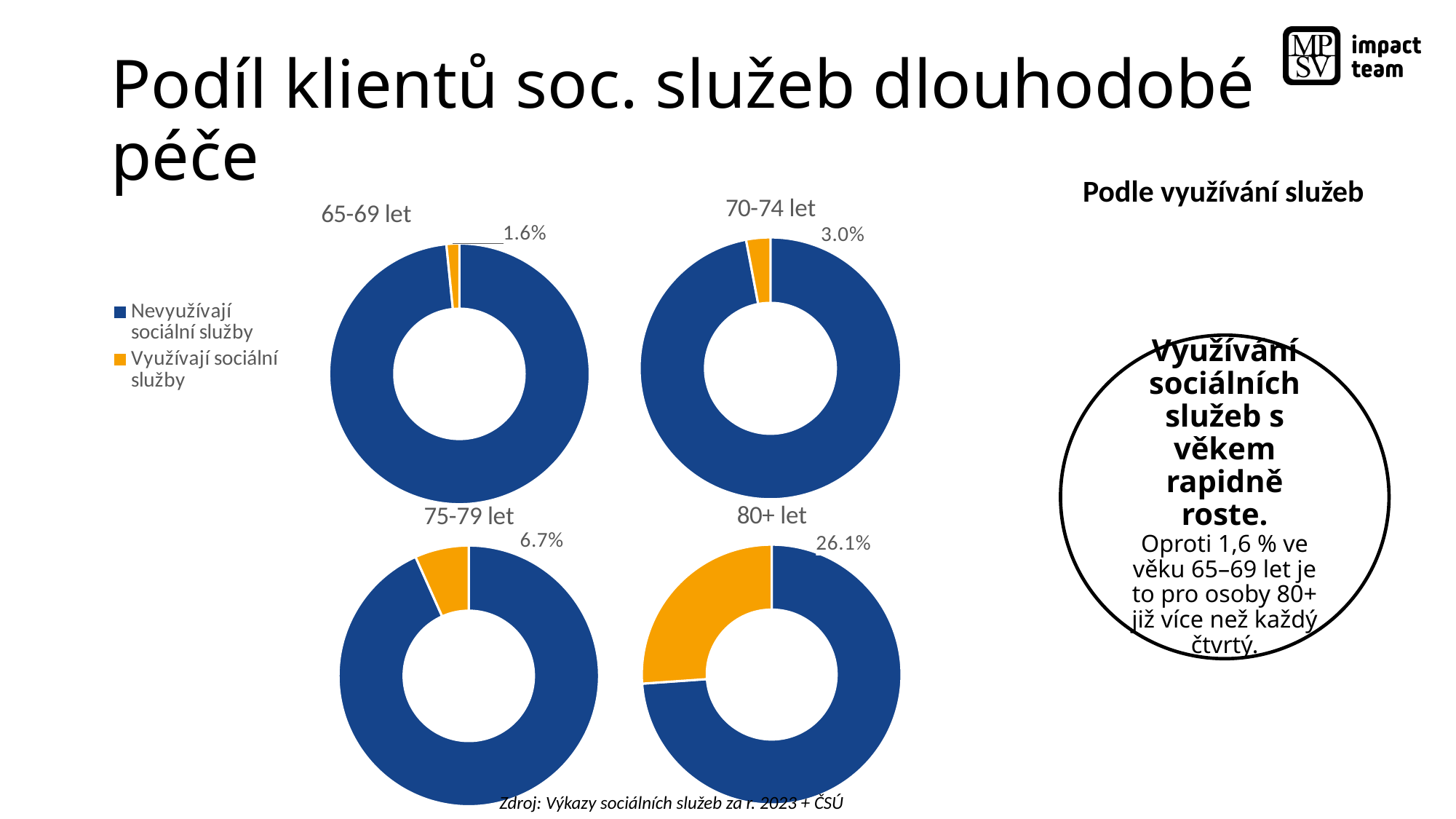
How many series does the legend list for the charts? 2 Across the four donut charts, which age group has the highest labelled share of 'Využívají sociální služby'? 80+ let How many donut charts are shown on the slide? 4 In the '80+ let' chart, which segment is larger: 'Nevyužívají sociální služby' or 'Využívají sociální služby'? Nevyužívají sociální služby In the '65-69 let' chart, what share is labelled for 'Využívají sociální služby'? 1.6% Which is larger: the labelled share in the '75-79 let' chart or in the '70-74 let' chart? 75-79 let In the '75-79 let' chart, what share is labelled for 'Využívají sociální služby'? 6.7% What is the difference between the labelled share in the '80+ let' chart and the labelled share in the '65-69 let' chart? 24.5% What type of chart is used for the '65-69 let' data? Donut (pie) chart In the '80+ let' chart, what share is labelled for 'Využívají sociální služby'? 26.1% In the '70-74 let' chart, what share is labelled for 'Využívají sociální služby'? 3.0% Across the four donut charts, which age group has the lowest labelled share of 'Využívají sociální služby'? 65-69 let